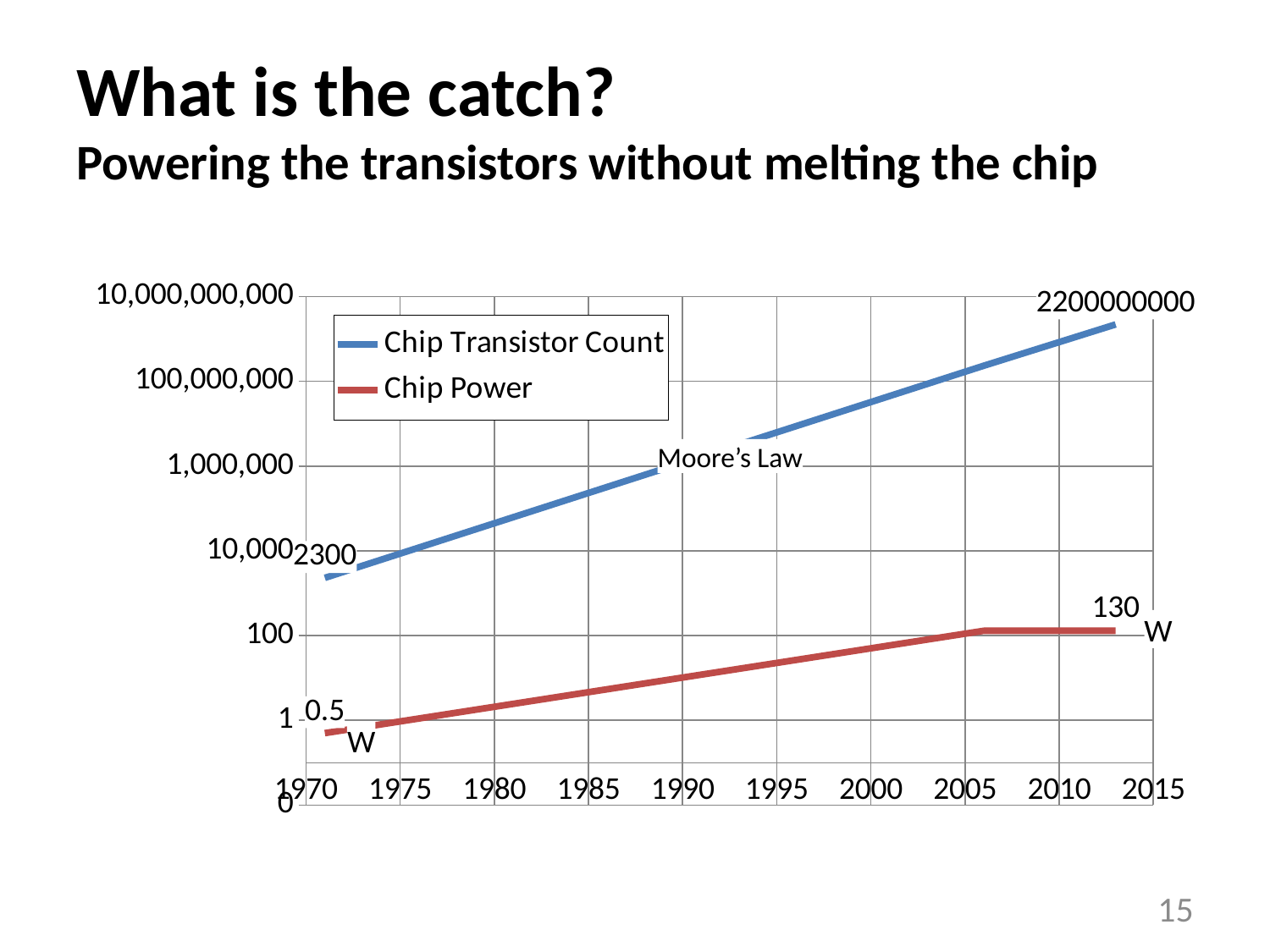
What annotation text is written next to the Chip Transistor Count line? Moore's Law Is the Chip Power value around 1990 greater or less than 100? less Which series has the higher value around 2010, Chip Transistor Count or Chip Power? Chip Transistor Count By how much does the Chip Power end label (130) exceed its start label (0.5)? 129.5 How many series does the legend list? 2 What is the data label at the start of the Chip Transistor Count line? 2300 What kind of chart is shown on the slide? Line chart Does the Chip Transistor Count line rise or fall from 1970 to 2015? Rise What is the data label at the end of the Chip Power line? 130 Is the Chip Transistor Count value around 2000 greater or less than 1,000,000? greater What is the data label at the start of the Chip Power line? 0.5 What is the data label at the end of the Chip Transistor Count line? 2200000000